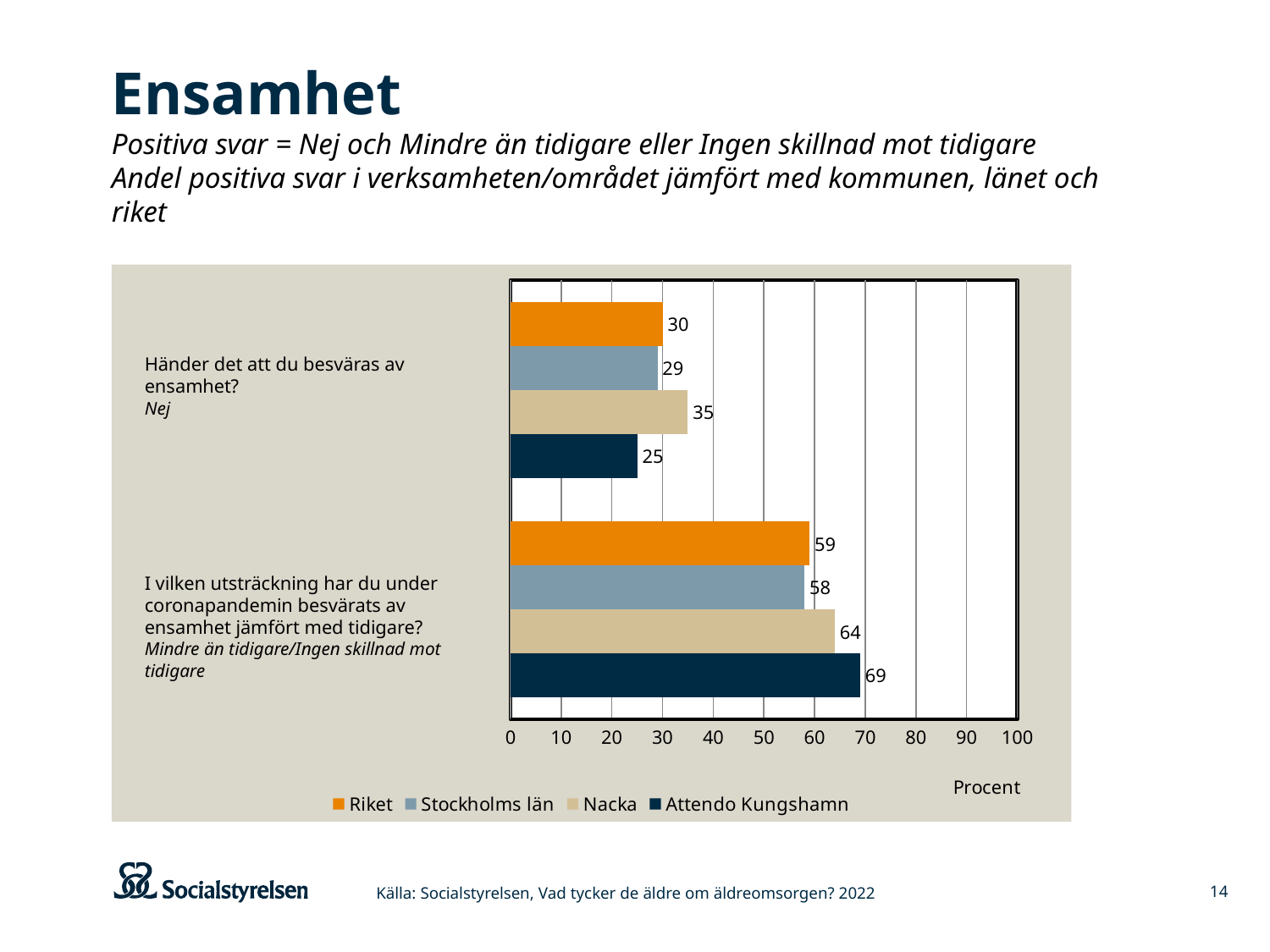
Which is larger on the question 'Händer det att du besväras av ensamhet?': Nacka or Stockholms län? Nacka Is the value for Attendo Kungshamn on the question 'I vilken utsträckning har du under coronapandemin besvärats av ensamhet jämfört med tidigare?' greater or less than 60? greater What is the value for Riket on the question 'Händer det att du besväras av ensamhet?' 30 Which series has the lowest value on the question 'Händer det att du besväras av ensamhet?' Attendo Kungshamn What is the difference between Attendo Kungshamn and Riket on the question 'I vilken utsträckning har du under coronapandemin besvärats av ensamhet jämfört med tidigare?' 10 What is the difference between Nacka and Attendo Kungshamn on the question 'Händer det att du besväras av ensamhet?' 10 What is the value for Nacka on the question 'I vilken utsträckning har du under coronapandemin besvärats av ensamhet jämfört med tidigare?' 64 How many series does the legend list? 4 Which series has the highest value on the question 'I vilken utsträckning har du under coronapandemin besvärats av ensamhet jämfört med tidigare?' Attendo Kungshamn What kind of chart is shown on the slide? Bar chart What is the value for Attendo Kungshamn on the question 'Händer det att du besväras av ensamhet?' 25 What unit is shown on the x axis of the chart? Procent